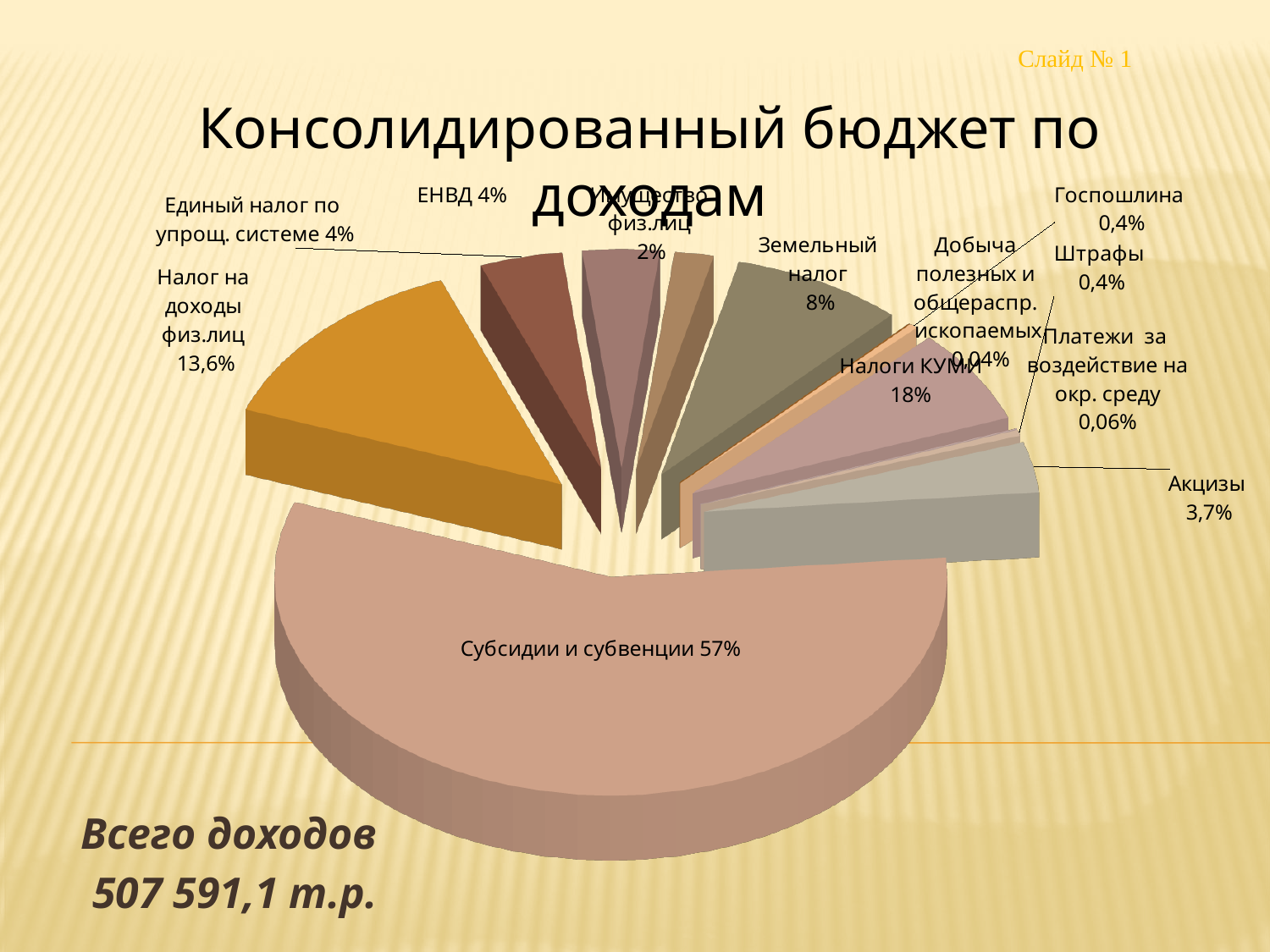
What is the value shown for "Налоги КУМИ"? 18% Which category has the smallest share of the pie? Добыча полезных и общераспр. ископаемых What total income amount is stated on the slide? 507 591,1 т.р. How many slices does the pie chart have? 12 What is the value shown for "Земельный налог"? 8% What kind of chart is shown on the slide? pie chart Which is larger, the share of "Налог на доходы физ.лиц" or the share of "Земельный налог"? Налог на доходы физ.лиц Which category has the largest share of the pie? Субсидии и субвенции What is the value shown for "Налог на доходы физ.лиц"? 13,6% What is the value shown for "Акцизы"? 3,7% What share of the pie does "Субсидии и субвенции" take? 57% What is the difference between the shares of "Налоги КУМИ" and "Земельный налог"? 10%